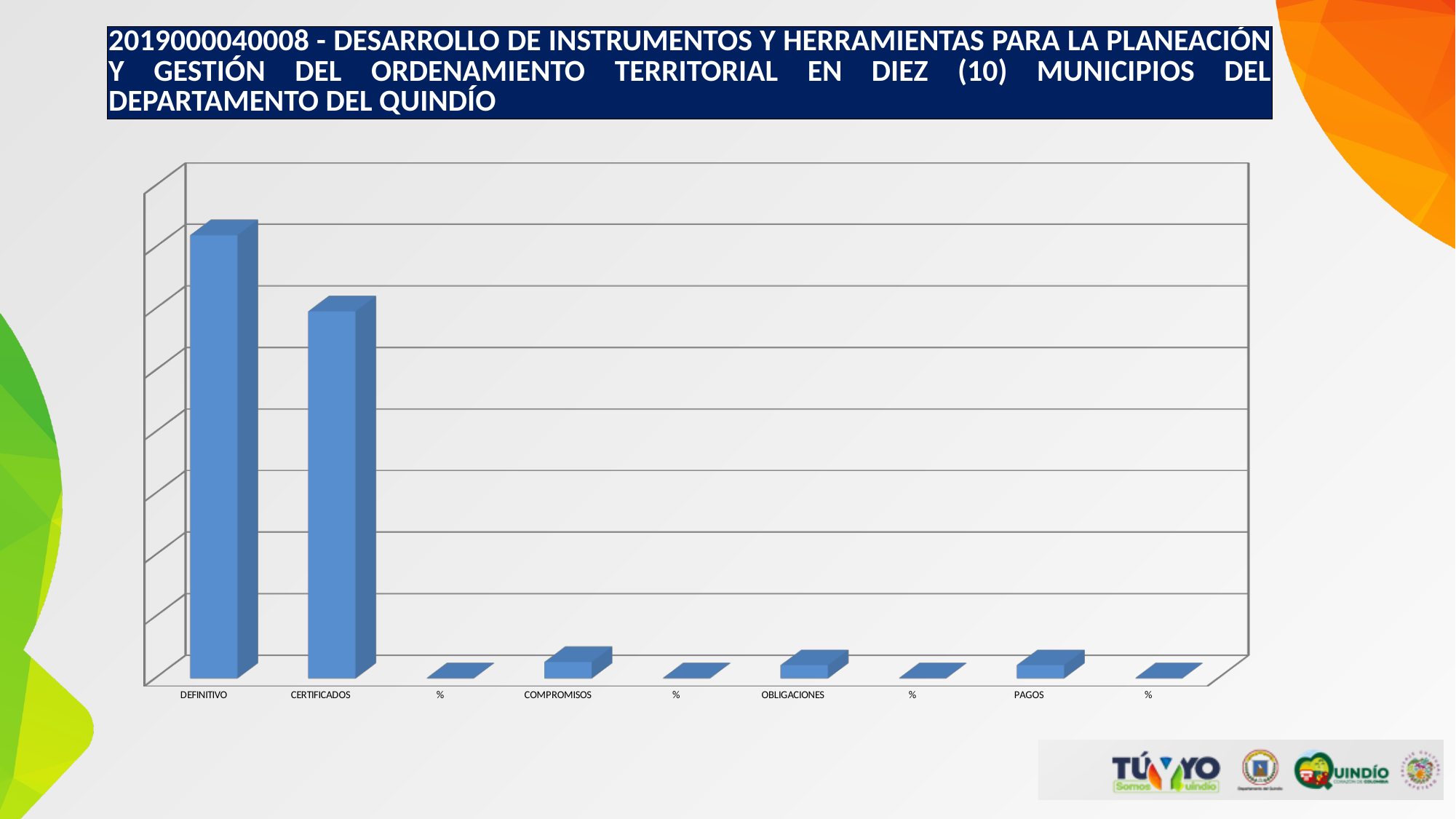
Which is larger, the bar for DEFINITIVO or the bar for CERTIFICADOS? DEFINITIVO How many categories are shown along the x axis of the chart? 9 What colour are the bars in the chart? Blue What kind of chart is shown on the slide? Bar chart What is the label of the first category on the x axis of the chart? DEFINITIVO Which is larger, the bar for CERTIFICADOS or the bar for COMPROMISOS? CERTIFICADOS Which is larger, the bar for CERTIFICADOS or the bar for OBLIGACIONES? CERTIFICADOS Which category has the highest bar in the chart? DEFINITIVO